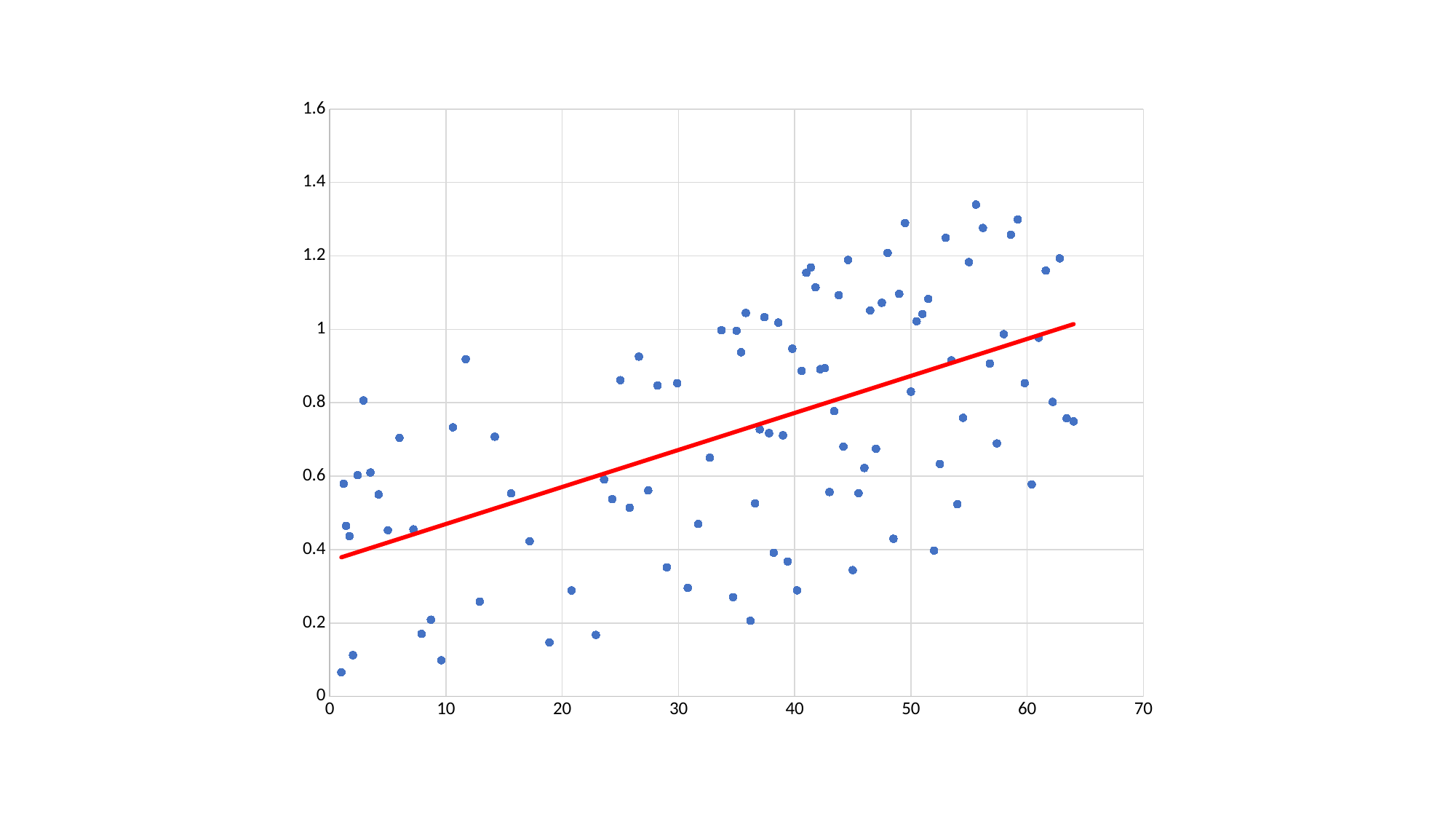
Is the value of the red trend line at x = 50 greater or less than 0.8? greater Is the highest plotted point greater or less than 1.2 on the y axis? greater What kind of chart is shown on the slide? scatter chart Are any plotted points above 1.4 on the y axis? no Does the red trend line slope upward or downward from left to right? upward Do the plotted values generally rise or fall as the x-axis value increases? rise What colour is the trend line on the chart? red What is the highest tick value shown on the x axis? 70